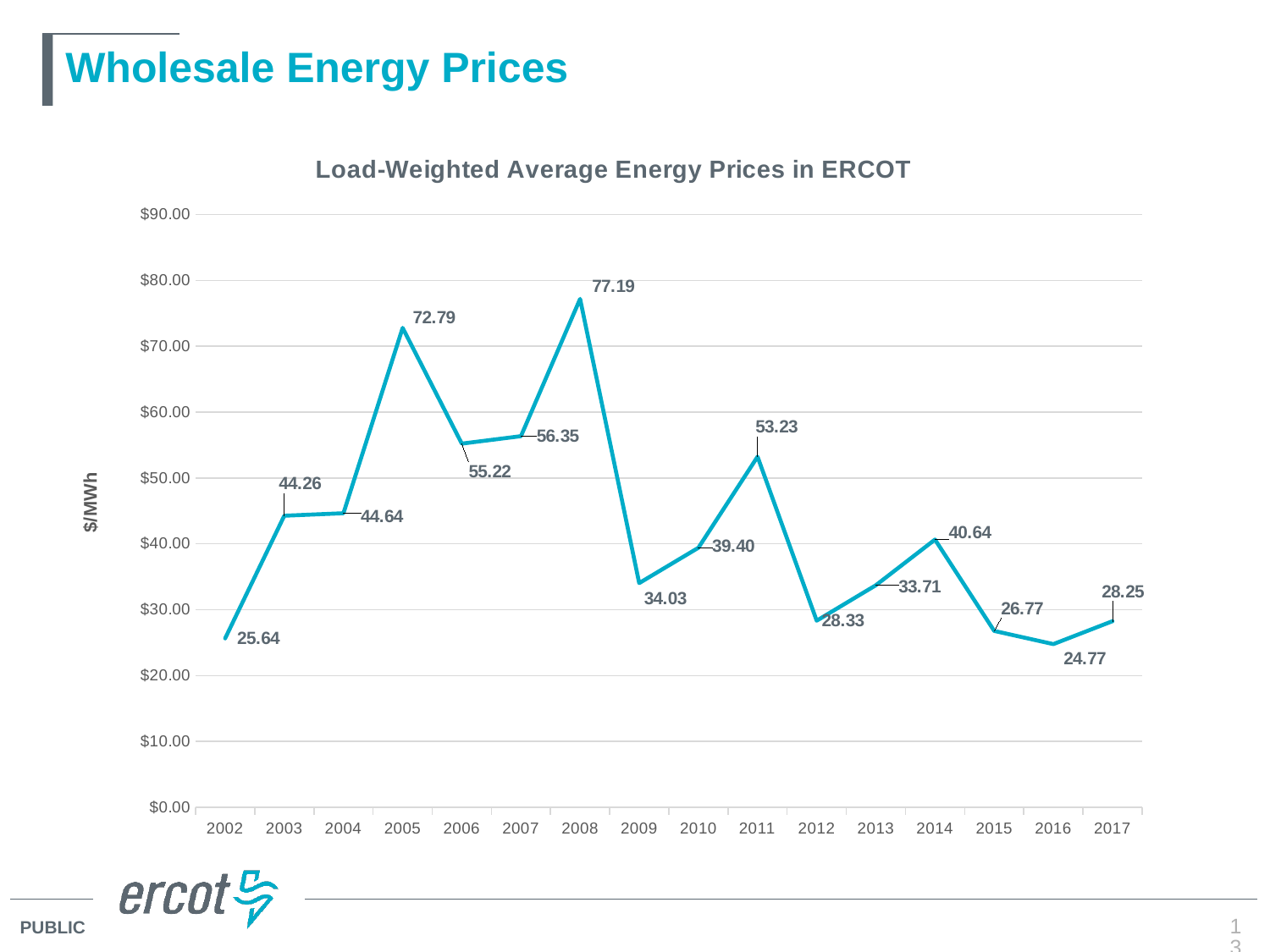
What is the title of the chart? Load-Weighted Average Energy Prices in ERCOT Which year has the lowest load-weighted average energy price? 2016 How many years are plotted on the chart? 16 What is the difference between the values for 2011 and 2012? 24.90 Which year has the highest load-weighted average energy price? 2008 What is the difference between the values for 2008 and 2005? 4.40 Is the value for 2005 greater or less than $70.00? greater What is the value shown for 2014? 40.64 What is the load-weighted average energy price for 2008? 77.19 What is the value shown for 2002? 25.64 What kind of chart is shown on the slide? Line chart Which year has the larger value, 2006 or 2011? 2006